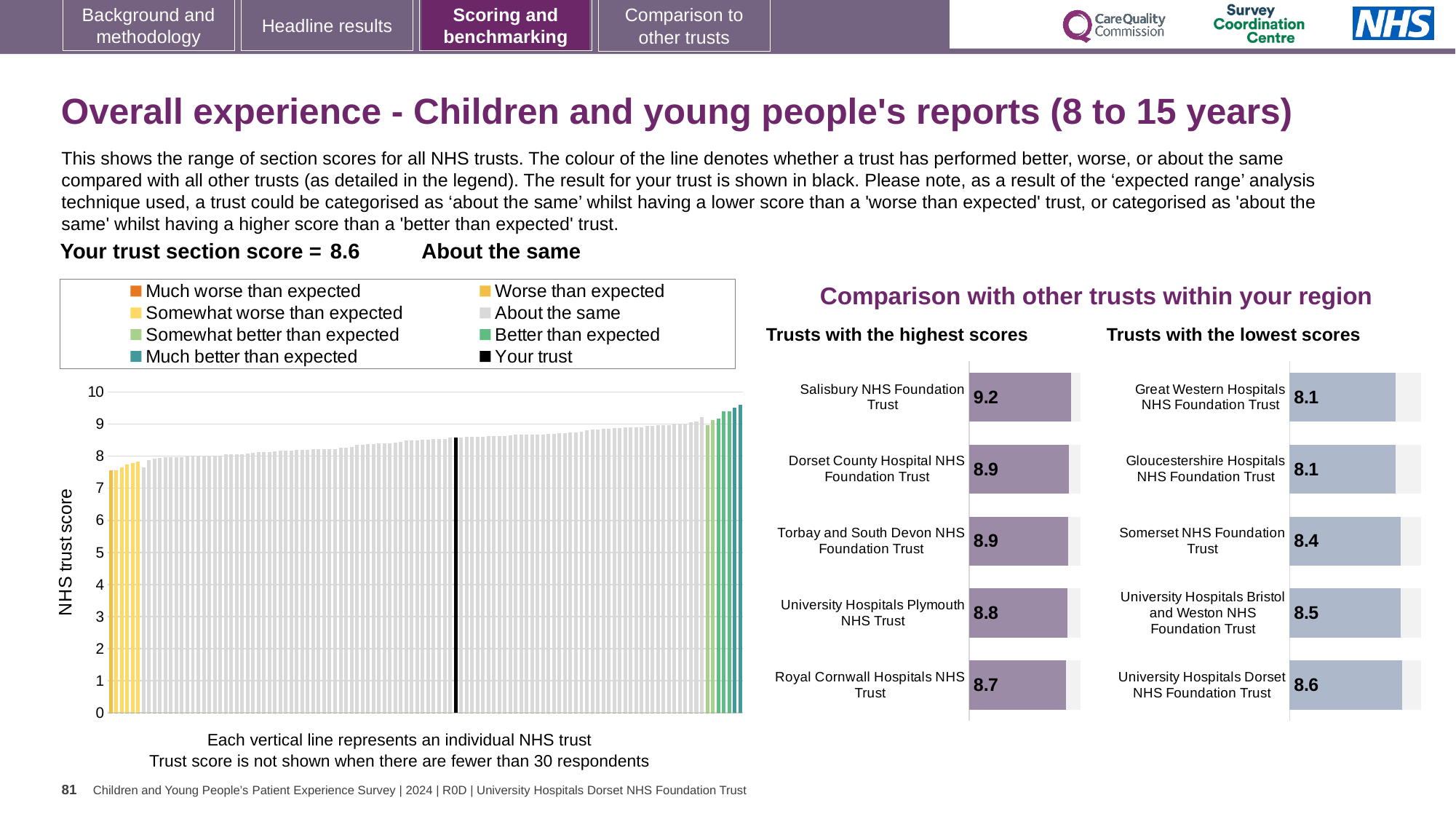
In the 'Trusts with the highest scores' chart, what is the score for Royal Cornwall Hospitals NHS Trust? 8.7 How many trusts are shown in the 'Trusts with the highest scores' chart? 5 How many entries does the legend of the main 'NHS trust score' chart list? 8 In the main 'NHS trust score' chart, do the trust scores rise or fall from left to right? rise In the main 'NHS trust score' chart, is the value for the black 'Your trust' line greater or less than 8? greater In the 'Trusts with the lowest scores' chart, which has the larger score: Somerset NHS Foundation Trust or University Hospitals Bristol and Weston NHS Foundation Trust? University Hospitals Bristol and Weston NHS Foundation Trust In the 'Trusts with the lowest scores' chart, which trust has the highest score shown? University Hospitals Dorset NHS Foundation Trust In the 'Trusts with the highest scores' chart, which trust has the highest score? Salisbury NHS Foundation Trust In the 'Trusts with the highest scores' chart, what is the score for Salisbury NHS Foundation Trust? 9.2 In the 'Trusts with the highest scores' chart, what is the difference between the scores of Salisbury NHS Foundation Trust and Royal Cornwall Hospitals NHS Trust? 0.5 In the 'Trusts with the lowest scores' chart, what is the score for University Hospitals Dorset NHS Foundation Trust? 8.6 In the 'Trusts with the lowest scores' chart, what is the score for Somerset NHS Foundation Trust? 8.4